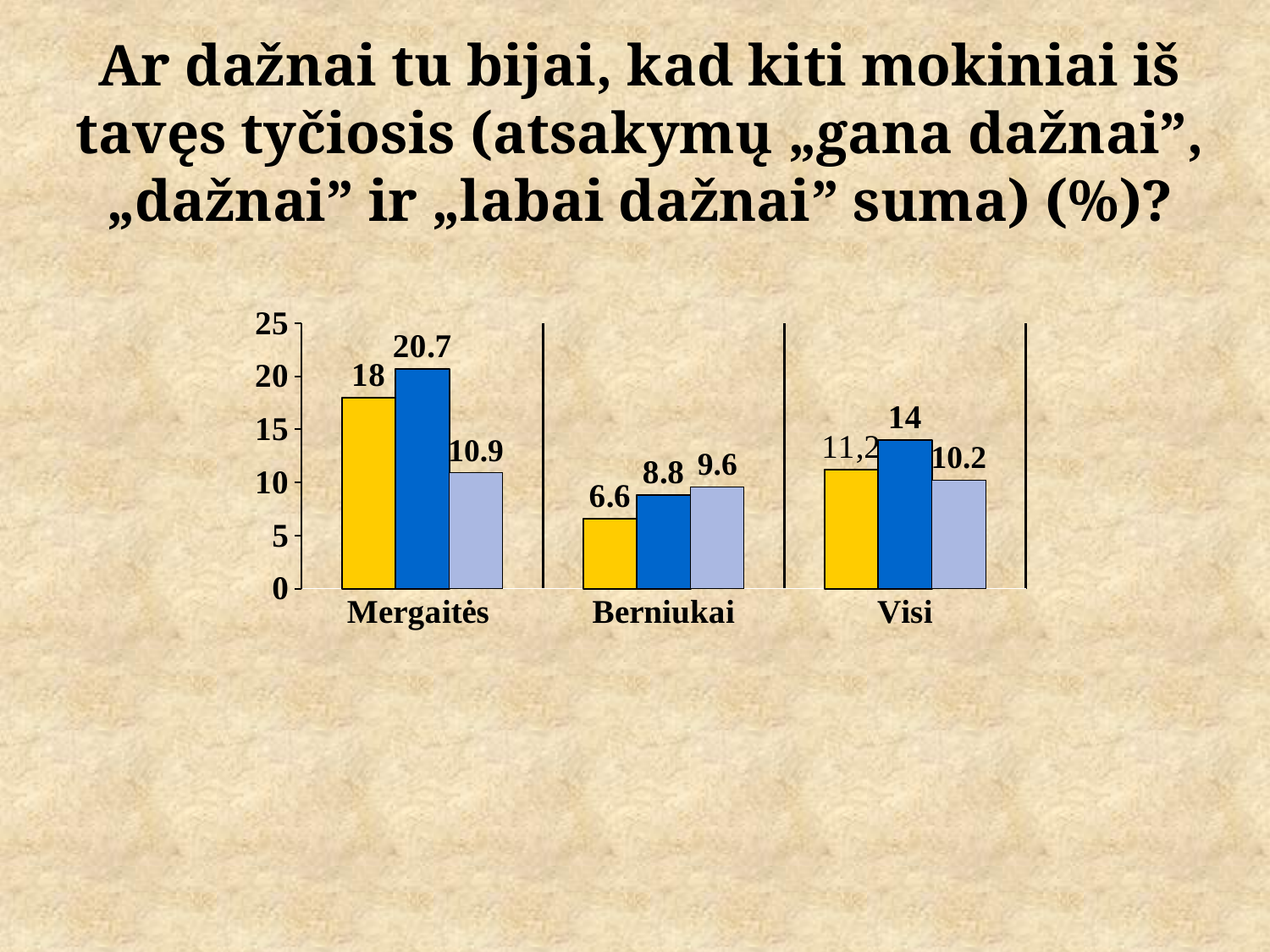
How many categories are shown on the x axis? 3 What is the value of the yellow bar for Mergaitės? 18 What is the value of the dark blue bar for Visi? 14 Is the value of the yellow bar for Mergaitės greater or less than 15? greater Which category has the highest dark blue bar? Mergaitės Which category has the lowest yellow bar? Berniukai What is the difference between the dark blue bar for Mergaitės and the dark blue bar for Berniukai? 11.9 Which is larger for Berniukai: the dark blue bar or the light blue bar? the light blue bar What kind of chart is shown on the slide? bar chart What is the value of the dark blue bar for Mergaitės? 20.7 What is the value of the light blue bar for Berniukai? 9.6 What is the value of the yellow bar for Berniukai? 6.6